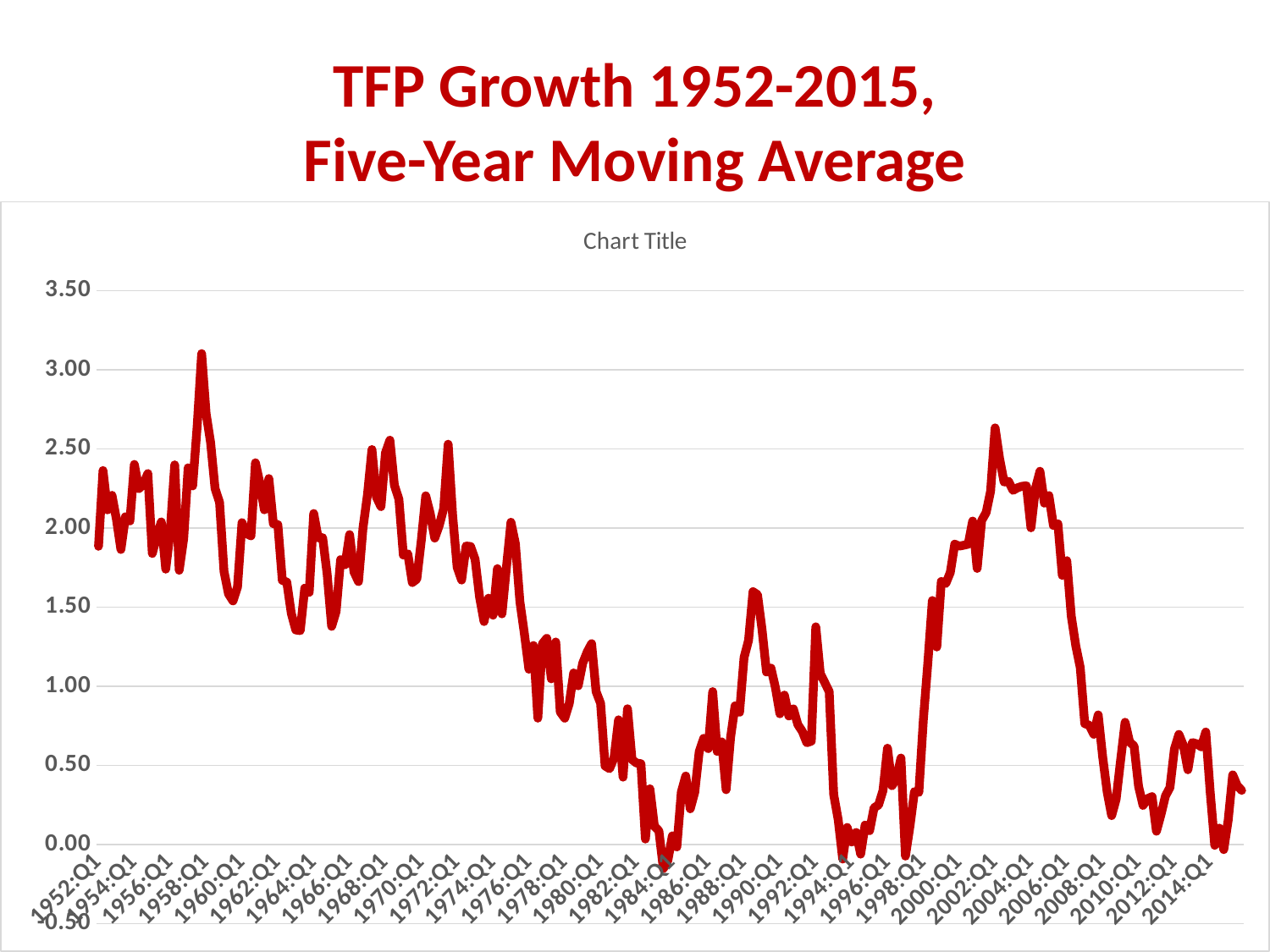
Is the value at 1984:Q1 greater or less than 0.50? less Is the value at 2014:Q1 greater or less than 0.50? less What kind of chart is shown on the slide? line chart What is the title of the slide above the chart? TFP Growth 1952-2015, Five-Year Moving Average Is the highest point of the line greater or less than 2.50? greater Around which x-axis label does the line reach its highest point? 1958:Q1 Does the line rise or fall between 1998:Q1 and 2002:Q1? rise What colour is the plotted line? red Overall, does the line rise or fall from 1952:Q1 to the end of the series? fall